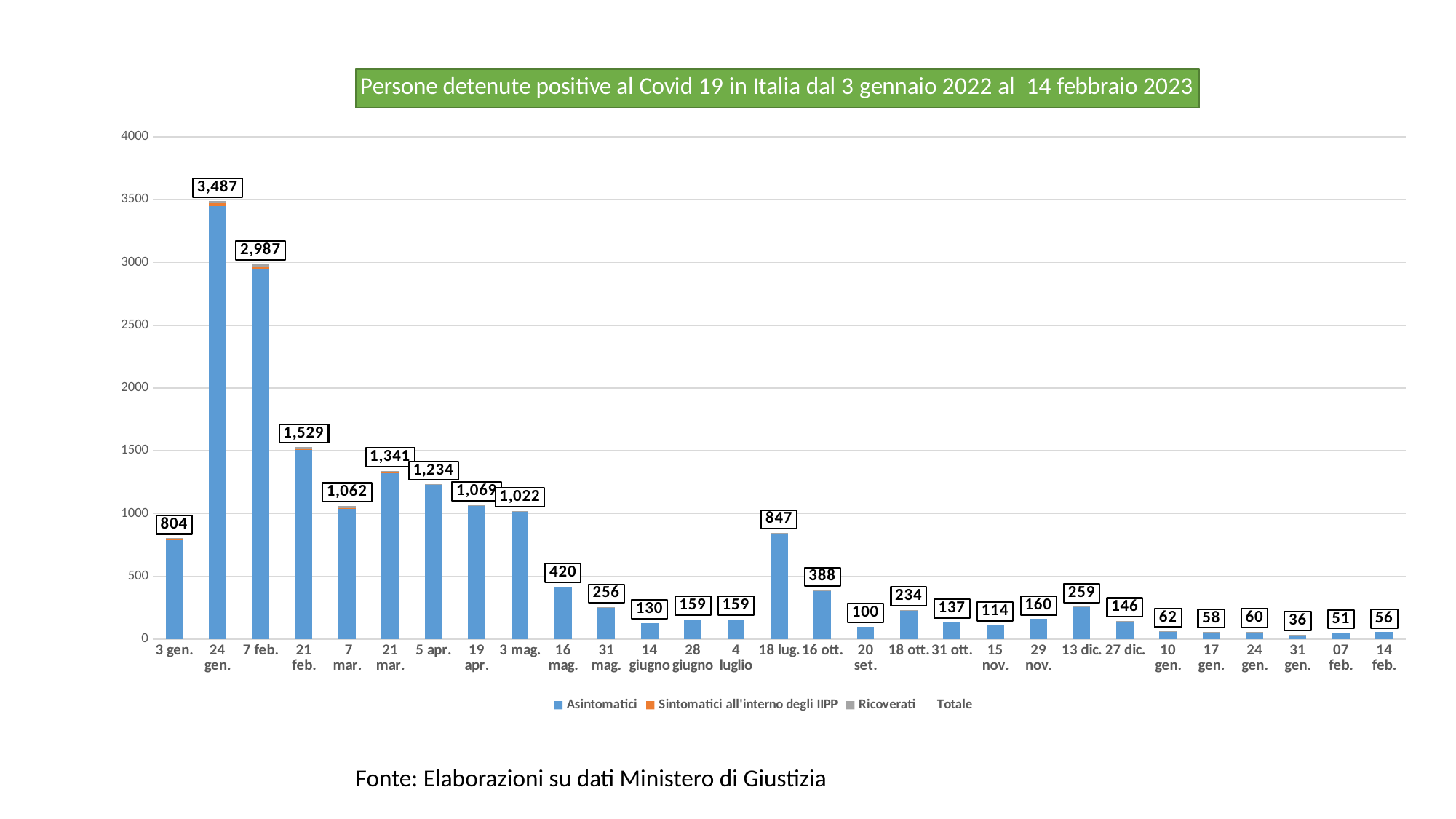
Is the total for 3 gen. greater or less than 1000? less How many dates are shown on the x axis? 29 Which date has the highest total? 24 gen. (the second bar) What kind of chart is shown? Stacked bar chart What is the total value shown for 14 feb.? 56 What is the total value shown for 18 lug.? 847 How many entries does the legend list? 4 What is the difference between the totals for 21 feb. and 21 mar.? 188 What is the difference between the totals for 18 lug. and 16 ott.? 459 Which has a larger total, 5 apr. or 19 apr.? 5 apr. What is the total value shown for 7 feb.? 2,987 Which date has the lowest total? 31 gen.